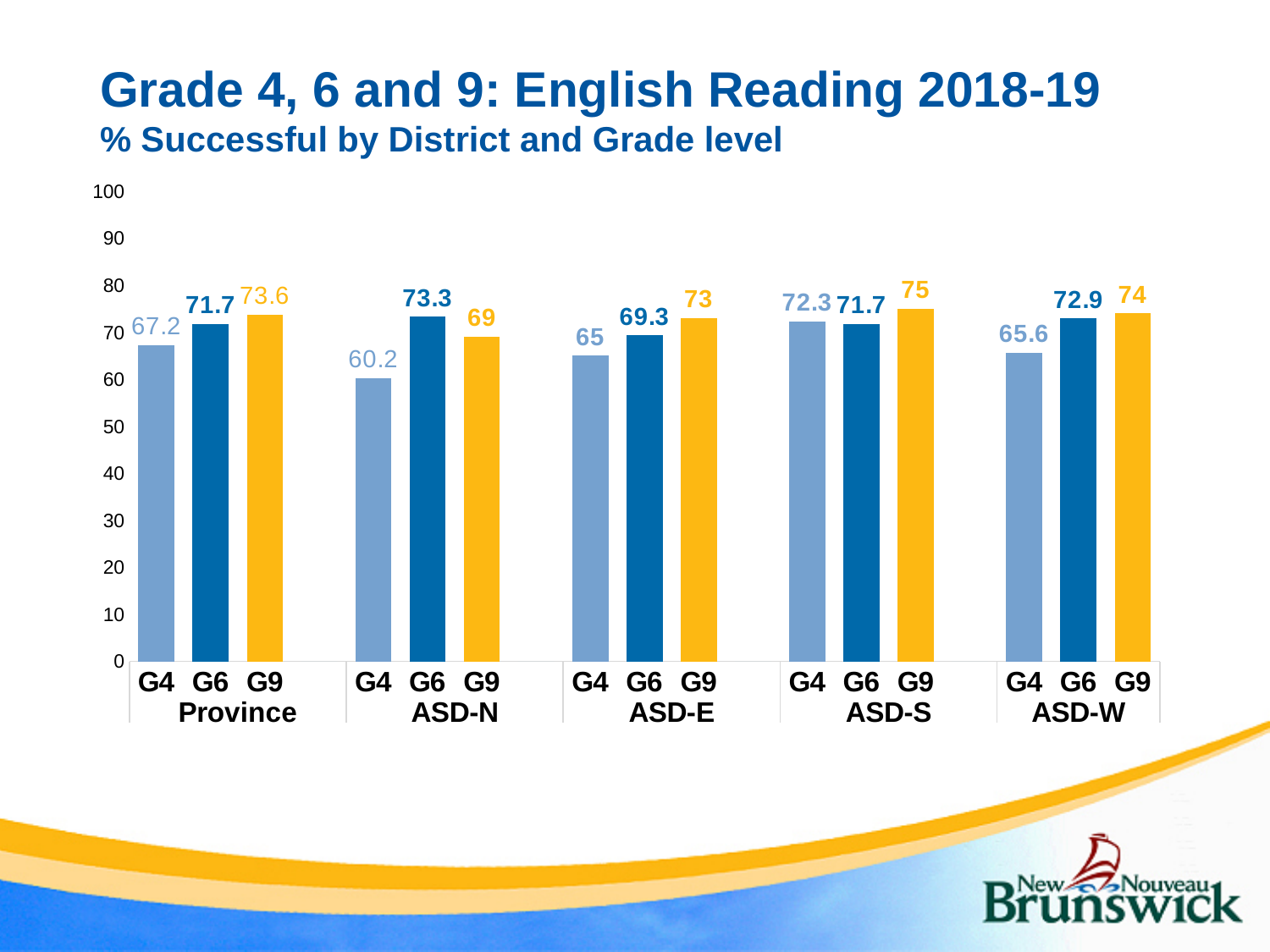
What is the difference between the G6 values for ASD-N and ASD-E? 4 Which district group has the highest G9 value? ASD-S What is the value for G4 in ASD-W? 65.6 What is the value for G4 in ASD-N? 60.2 What is the difference between the G9 and G4 values in ASD-N? 8.8 How many district groups are shown on the x axis? 5 What kind of chart is shown on the slide? Bar chart Which district group has the lowest G4 value? ASD-N What is the value for G6 in the Province group? 71.7 What is the value for G9 in ASD-S? 75 Which is larger, the G4 value for ASD-S or the G4 value for ASD-E? ASD-S What is the title of the chart on the slide? Grade 4, 6 and 9: English Reading 2018-19